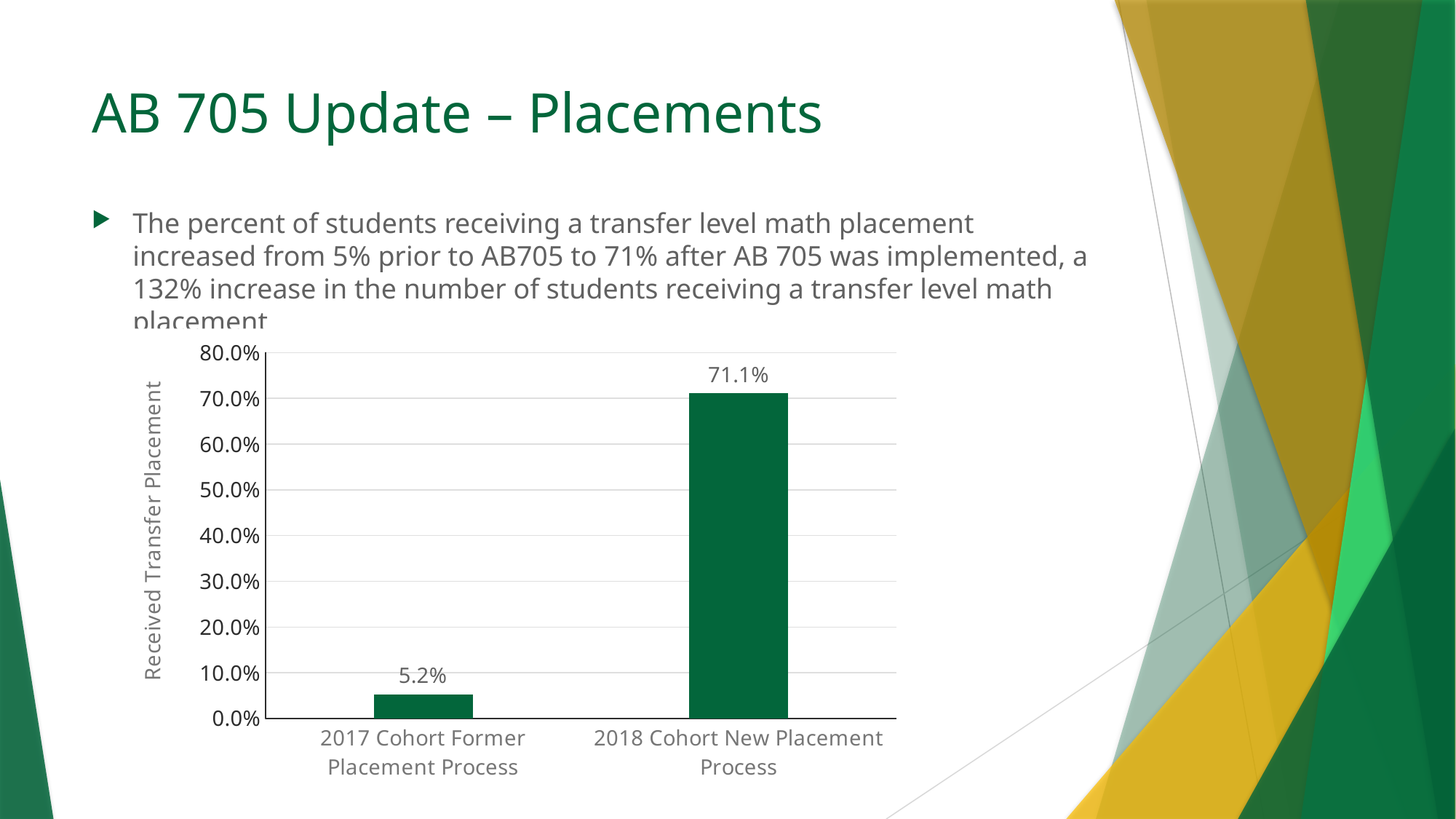
Do the values rise or fall from left to right along the x axis? rise Which category has the lowest value? 2017 Cohort Former Placement Process Which is larger, the value for 2017 Cohort Former Placement Process or 2018 Cohort New Placement Process? 2018 Cohort New Placement Process What is the value for 2017 Cohort Former Placement Process? 5.2% What is the value for 2018 Cohort New Placement Process? 71.1% Is the value for 2018 Cohort New Placement Process greater or less than 70.0%? greater Which category has the highest value? 2018 Cohort New Placement Process Is the value for 2017 Cohort Former Placement Process greater or less than 10.0%? less What is the label of the vertical axis? Received Transfer Placement What is the difference between the values for 2018 Cohort New Placement Process and 2017 Cohort Former Placement Process? 65.9% What kind of chart is shown on the slide? bar chart How many categories are shown on the x axis? 2